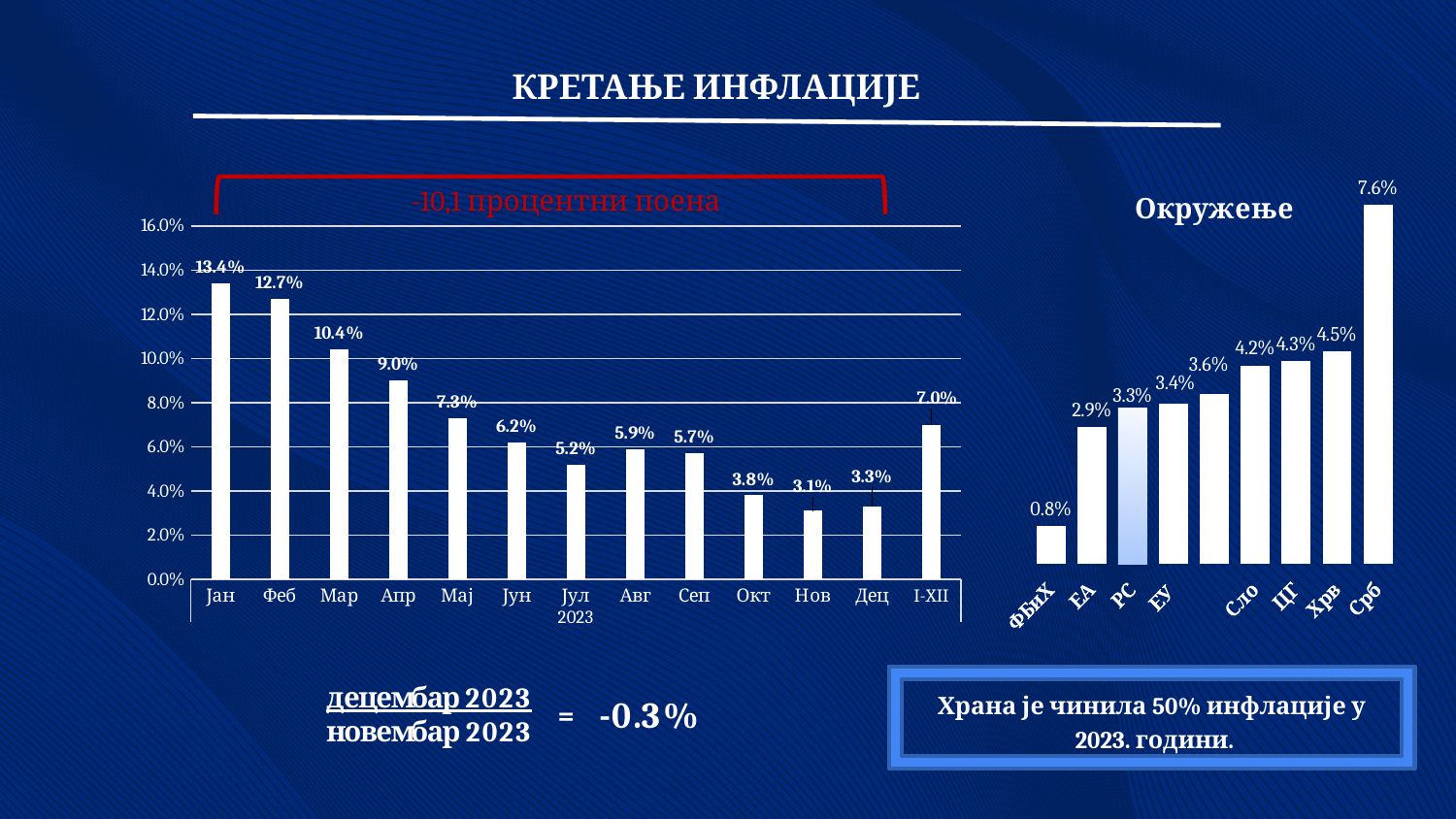
On the Окружење chart, what is the value for РС? 3.3% On the left chart, what is the inflation value for Јан? 13.4% On the left chart, do the values generally rise or fall from Јан to Дец? fall On the left chart, which month has the lowest value? Нов What type of chart is the Окружење chart? bar chart On the left chart, what is the value for I-XII? 7.0% On the Окружење chart, which category has the lowest value? ФБиХ On the left chart, which month has the highest value? Јан On the left chart, what is the difference between the values for Јан and Дец? 10.1% On the left chart, which is larger, the value for Авг or the value for Сеп? Авг On the left chart, what is the value for Нов? 3.1% On the Окружење chart, what is the value for Срб? 7.6%